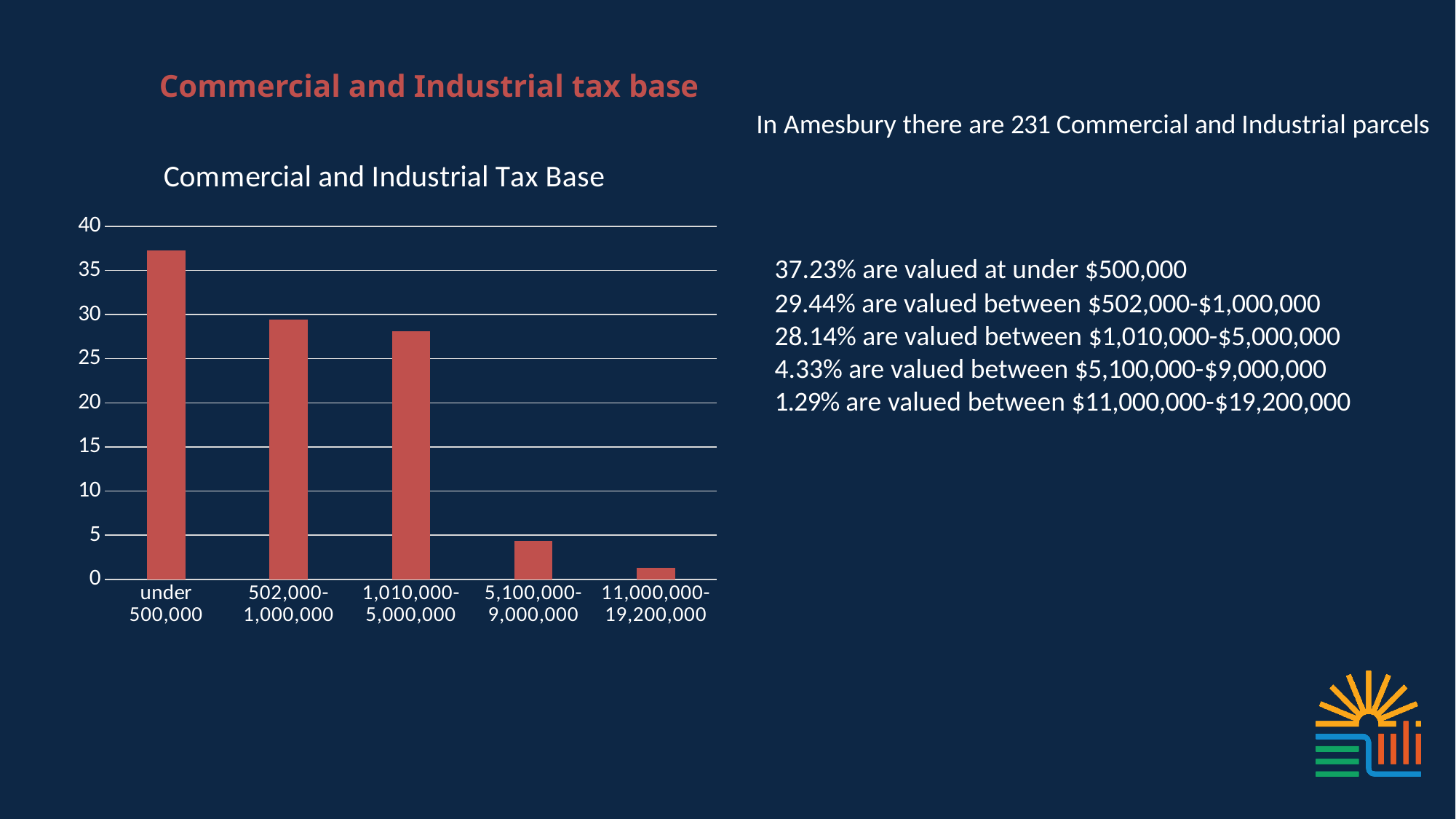
What colour are the bars in the chart? red How many categories are shown on the x axis of the chart? 5 Do the bar values rise or fall moving from left to right along the x axis? fall Is the value for under 500,000 greater or less than 35? greater What kind of chart is shown on the slide? bar chart Which is larger, the value for under 500,000 or the value for 1,010,000-5,000,000? under 500,000 Which category has the lowest bar in the chart? 11,000,000-19,200,000 Which category has the highest bar in the chart? under 500,000 Is the value for 502,000-1,000,000 greater or less than 30? less Is the value for 5,100,000-9,000,000 greater or less than 5? less What is the title of the chart? Commercial and Industrial Tax Base